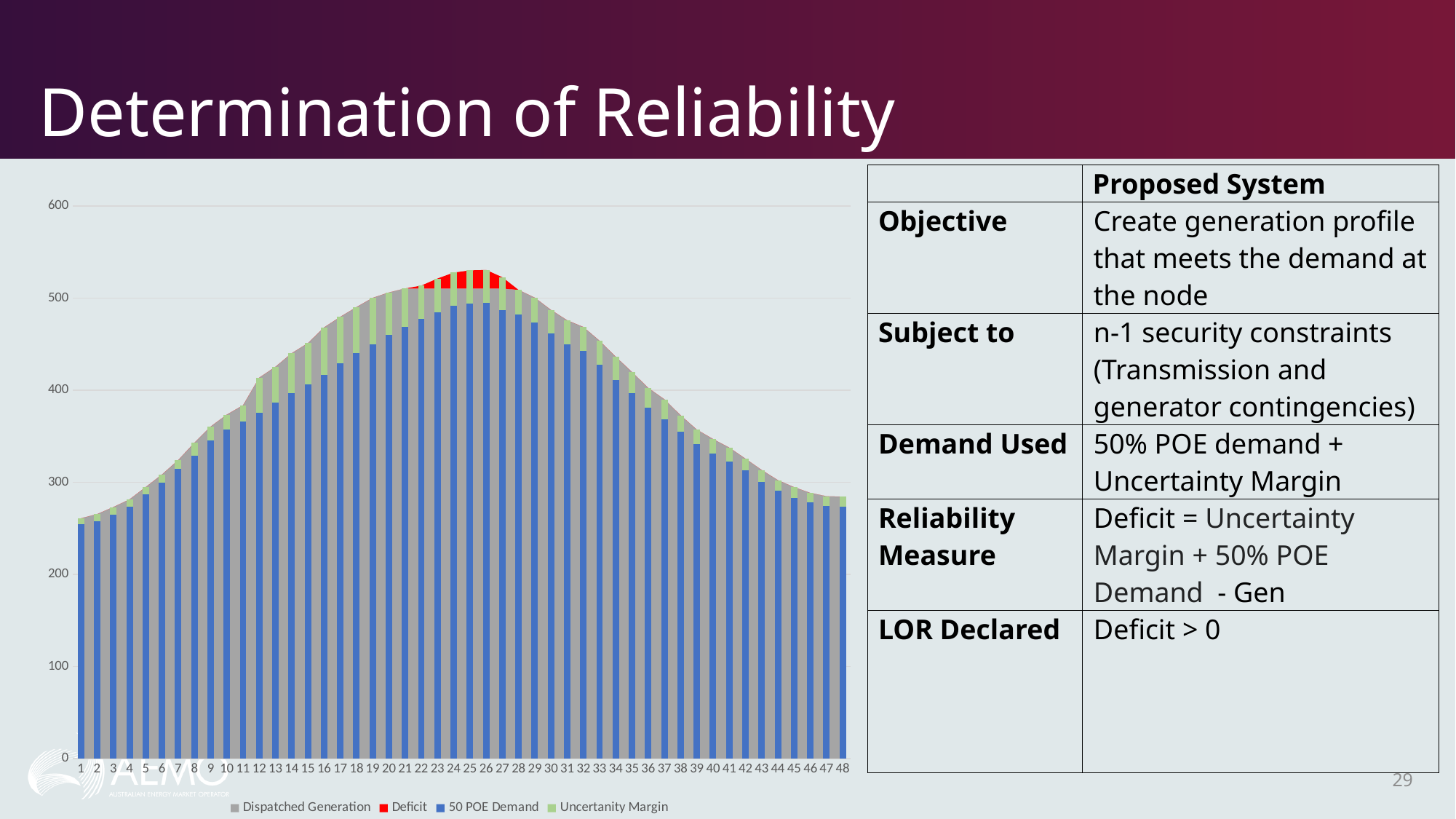
How many periods are shown along the x axis? 48 How many series does the legend list? 4 Is the 50 POE Demand value at period 12 greater or less than 400? less What colour represents the Deficit series? Red Which is larger, the 50 POE Demand at period 25 or at period 1? Period 25 Is the 50 POE Demand value at period 1 greater or less than 300? less Is the 50 POE Demand value at period 25 greater or less than 400? greater Does the 50 POE Demand rise or fall from period 26 to period 48? fall Does the 50 POE Demand rise or fall from period 1 to period 25? rise What are the series named in the legend? Dispatched Generation, Deficit, 50 POE Demand, Uncertanity Margin